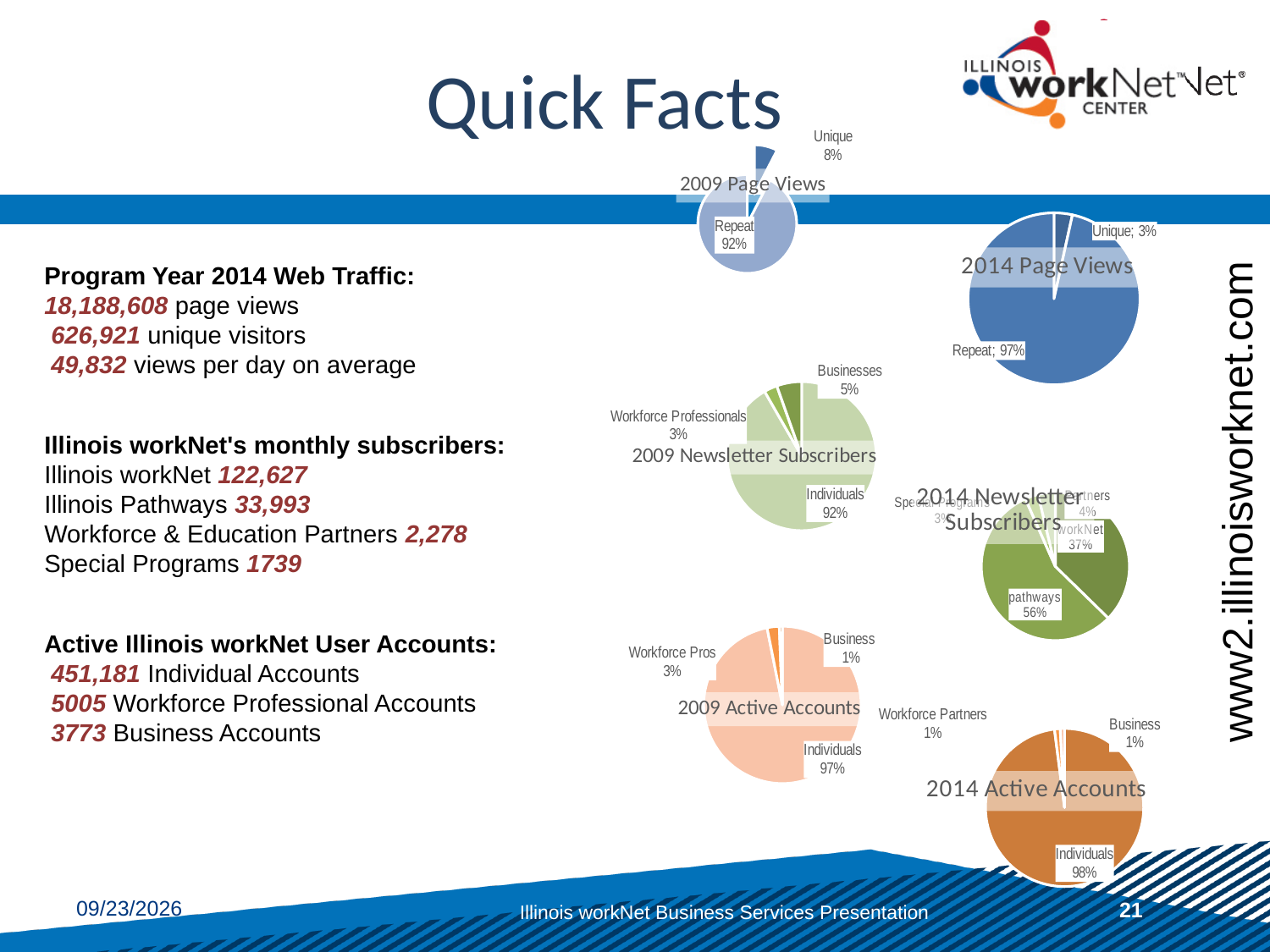
What kind of chart is the 2014 Active Accounts chart? Pie chart How many charts are shown on the slide? 6 In the 2009 Newsletter Subscribers chart, what share is Businesses? 5% In the 2014 Newsletter Subscribers chart, what share is pathways? 56% In the 2009 Newsletter Subscribers chart, which category has the largest share? Individuals In the 2014 Page Views chart, what share of page views is Unique? 3% In the 2014 Newsletter Subscribers chart, what is the difference between the pathways share and the workNet share? 19%